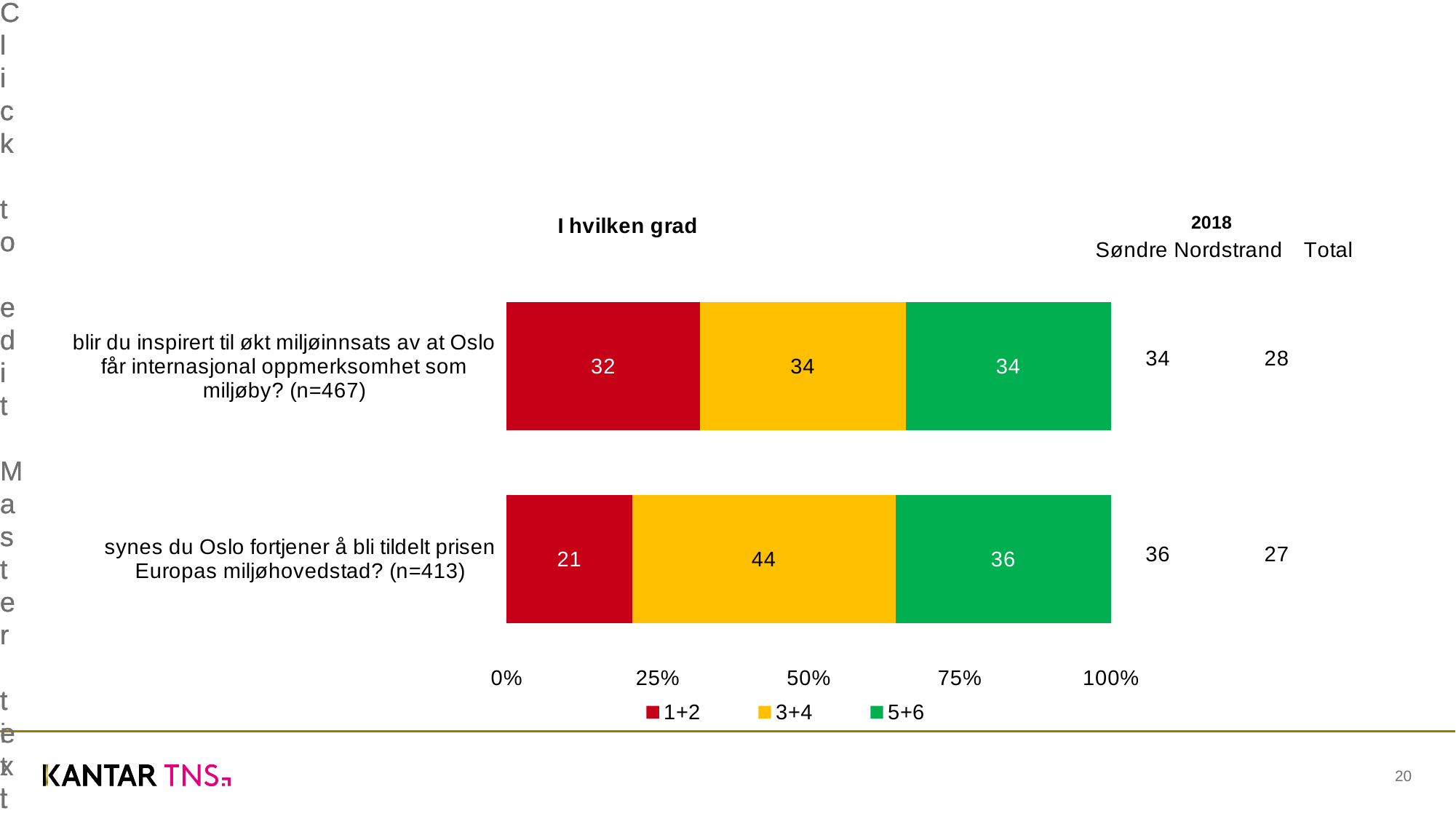
What kind of chart is shown on the slide? Stacked bar chart Which bar has the larger 3+4 value: "blir du inspirert til økt miljøinnsats..." or "synes du Oslo fortjener å bli tildelt prisen..."? synes du Oslo fortjener å bli tildelt prisen Europas miljøhovedstad? (n=413) What is the total of the stacked bar for "blir du inspirert til økt miljøinnsats av at Oslo får internasjonal oppmerksomhet som miljøby? (n=467)"? 100 How many series does the legend list? 3 What is the value of the 5+6 segment for "synes du Oslo fortjener å bli tildelt prisen Europas miljøhovedstad? (n=413)"? 36 What is the value of the 3+4 segment for "synes du Oslo fortjener å bli tildelt prisen Europas miljøhovedstad? (n=413)"? 44 What is the value of the 1+2 segment for "blir du inspirert til økt miljøinnsats av at Oslo får internasjonal oppmerksomhet som miljøby? (n=467)"? 32 How many question categories are plotted in the chart? 2 Which segment is the largest in the bar for "synes du Oslo fortjener å bli tildelt prisen Europas miljøhovedstad? (n=413)"? 3+4 What is the difference between the 1+2 values of the two bars (32 and 21)? 11 Which segment is the smallest in the bar for "synes du Oslo fortjener å bli tildelt prisen Europas miljøhovedstad? (n=413)"? 1+2 What is the title shown above the chart? I hvilken grad